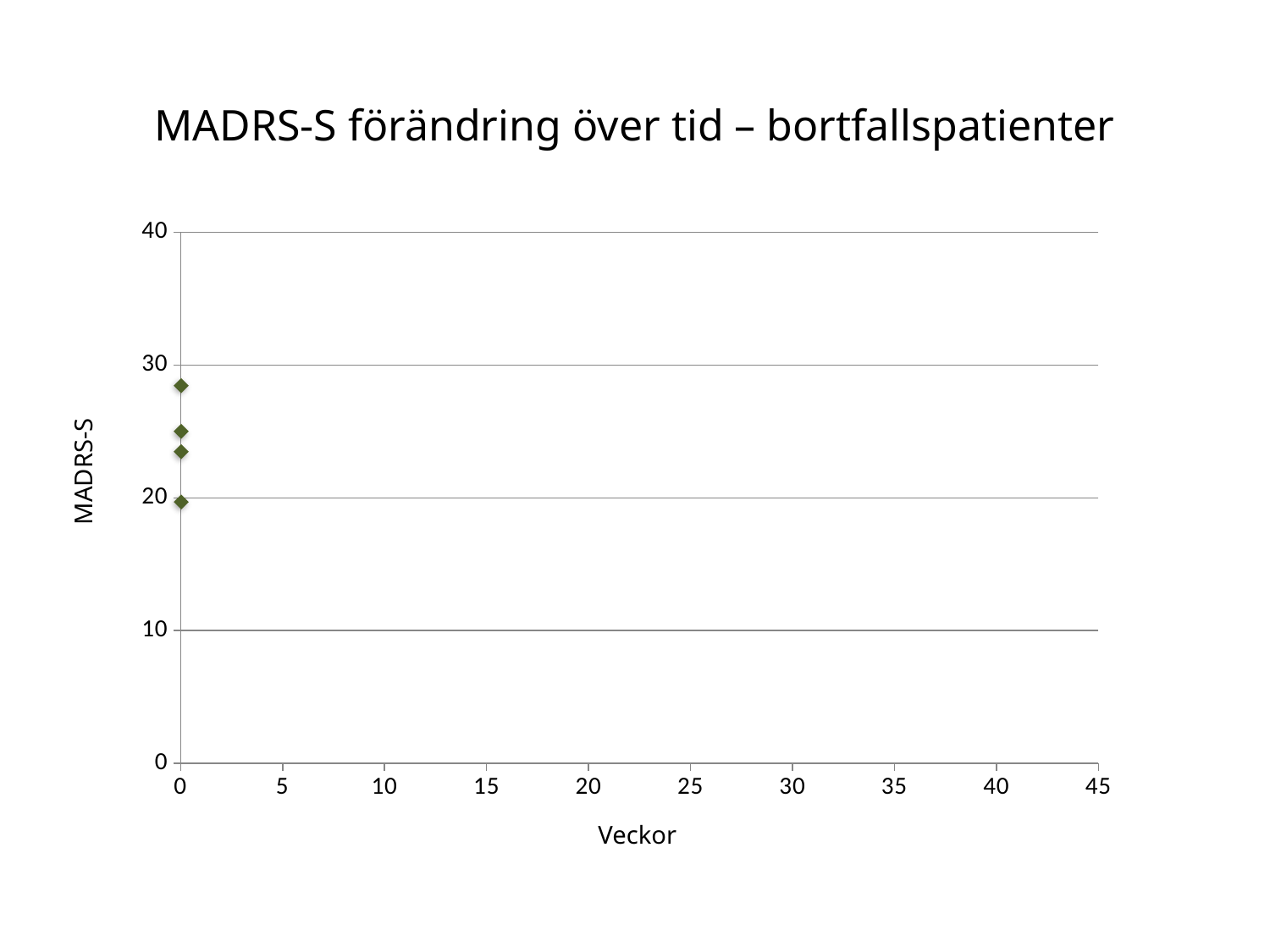
At which value on the Veckor axis are all the data points plotted? 0 Is the highest plotted MADRS-S value greater or less than 20? greater Is the highest plotted MADRS-S value greater or less than 30? less What is the highest tick value shown on the Veckor axis? 45 Are all plotted MADRS-S values greater or less than 10? greater What is the label of the horizontal axis? Veckor What is the highest tick value shown on the MADRS-S axis? 40 How many data points are plotted on the chart? 4 What is the title of the chart? MADRS-S förändring över tid – bortfallspatienter What kind of chart is shown on the slide? scatter chart